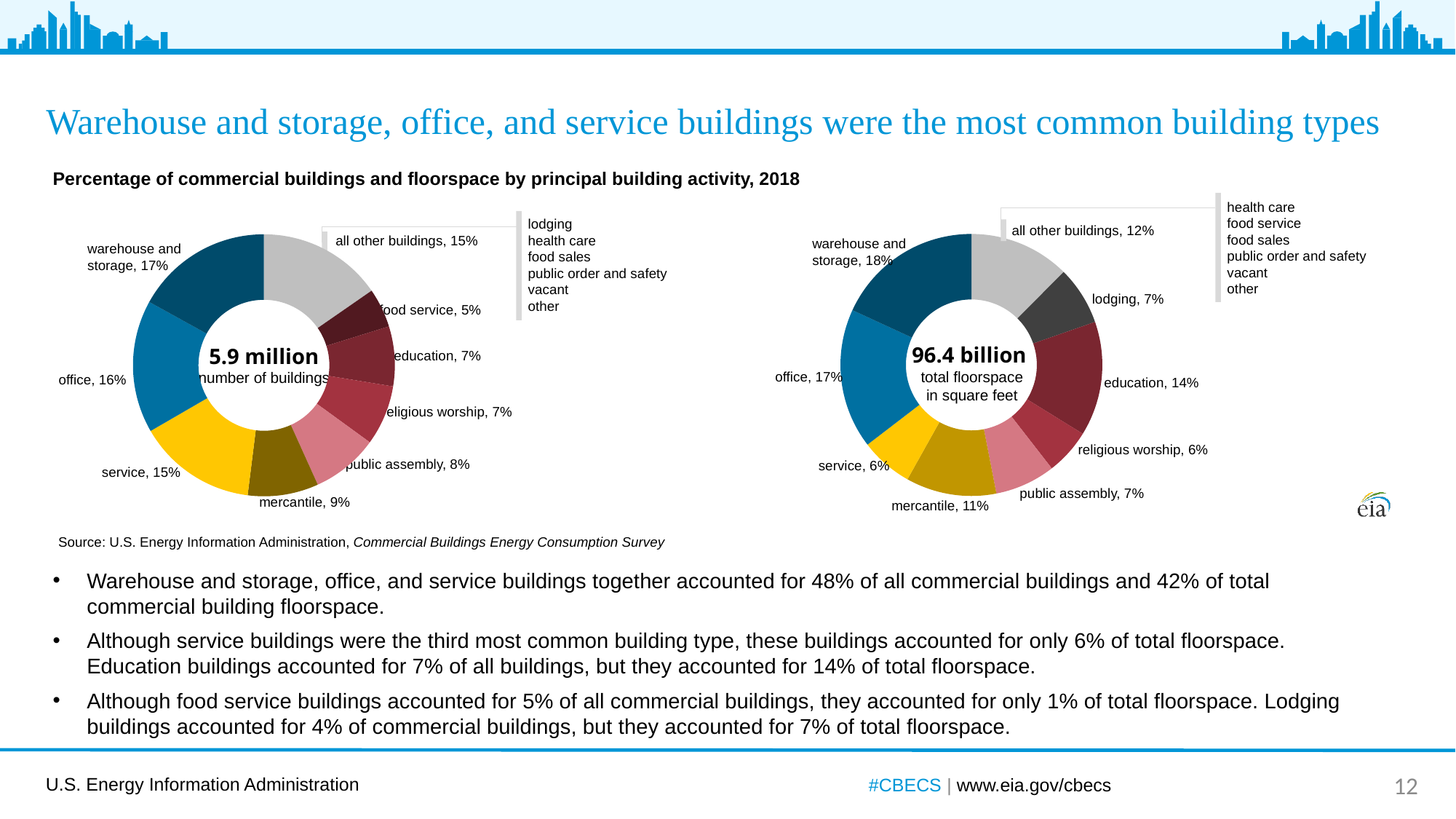
What is the difference in percentage points between service in the left chart (15%) and service in the right chart (6%)? 9 In the right donut chart (total floorspace), what percentage is education? 14% In the left donut chart (number of buildings), which labeled category has the smallest share? food service In the right donut chart (total floorspace), which is larger: office or mercantile? office In the right donut chart (total floorspace), which labeled category has the largest share? warehouse and storage In the left donut chart (number of buildings), which labeled category has the largest share? warehouse and storage How many slices does the left donut chart (number of buildings) have? 9 What total value is shown in the center of the right donut chart? 96.4 billion What type of chart is used on this slide? donut (pie) chart In the left donut chart (number of buildings), what percentage is warehouse and storage? 17% In the left donut chart (number of buildings), what percentage is food service? 5% In the right donut chart (total floorspace), what percentage is mercantile? 11%